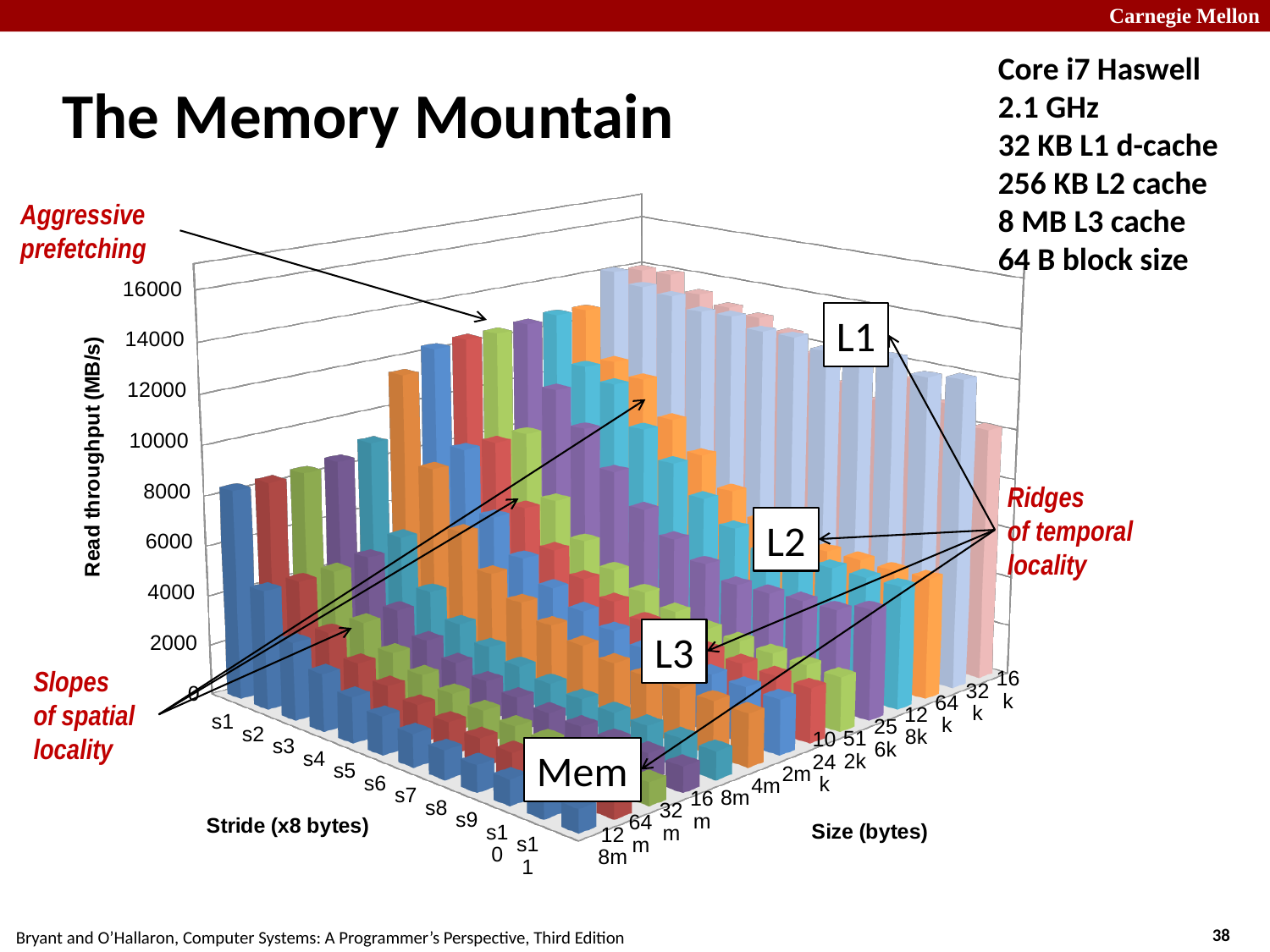
What is the highest tick value shown on the Read throughput (MB/s) axis? 16000 For a given working-set size, does read throughput rise or fall as the stride increases from s1 to s11? fall How many stride categories are shown along the Stride (x8 bytes) axis? 11 For a given stride, does read throughput rise or fall as the size decreases from 128m toward 16k? rise What is the label of the vertical axis of the chart? Read throughput (MB/s) Is the read throughput for stride s1 at the smallest size greater or less than the read throughput for stride s11 at the largest size? greater What kind of chart is shown on the slide? bar chart Which stride category has the lowest read throughput for the largest sizes? s11